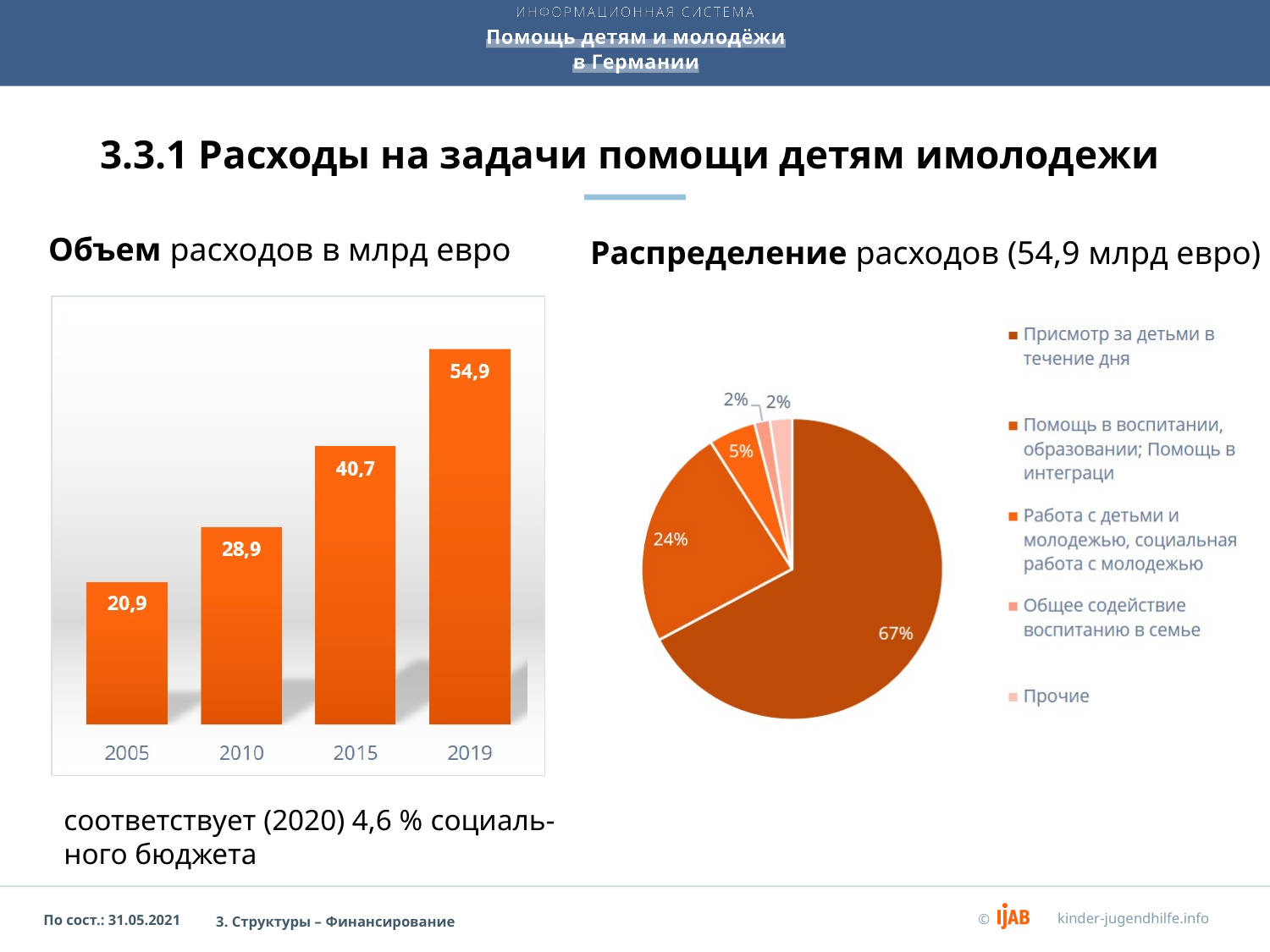
In the bar chart 'Объем расходов в млрд евро', what is the value for 2005? 20,9 How many years are shown in the bar chart 'Объем расходов в млрд евро'? 4 In the bar chart 'Объем расходов в млрд евро', what is the value for 2019? 54,9 In the bar chart 'Объем расходов в млрд евро', what is the value for 2010? 28,9 What kind of chart is the chart on the left of the slide? bar chart In the bar chart 'Объем расходов в млрд евро', which year has the highest value? 2019 In the pie chart 'Распределение расходов', what share does 'Работа с детьми и молодежью, социальная работа с молодежью' have? 5% In the bar chart 'Объем расходов в млрд евро', which year has the lowest value? 2005 In the bar chart 'Объем расходов в млрд евро', what is the difference between the values for 2019 and 2015? 14,2 How many entries does the legend of the pie chart 'Распределение расходов' list? 5 In the pie chart 'Распределение расходов', what share does 'Присмотр за детьми в течение дня' have? 67% In the bar chart 'Объем расходов в млрд евро', do the values rise or fall from 2005 to 2019? rise